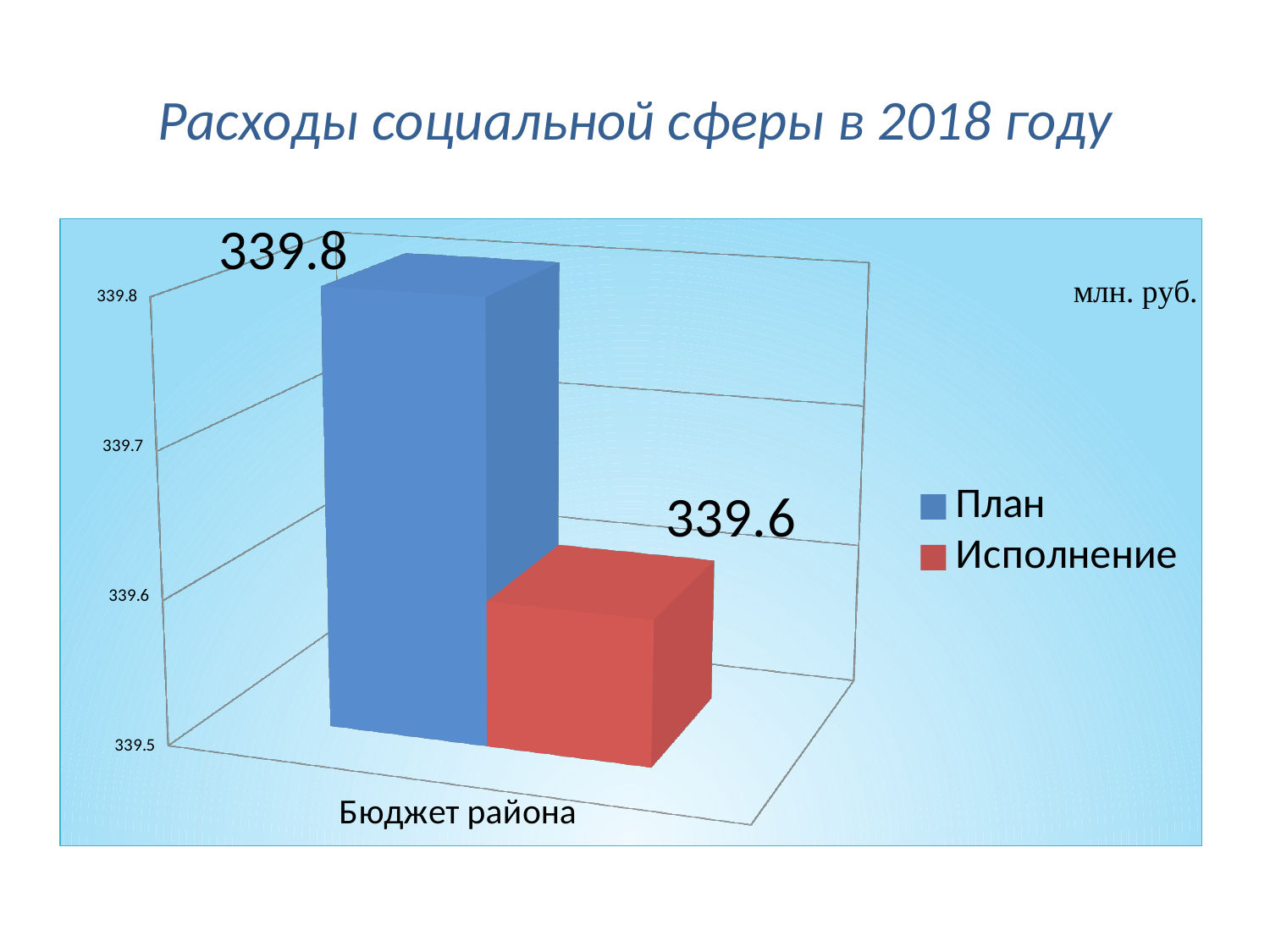
Which series has the higher value, План or Исполнение? План What is the difference between the План value and the Исполнение value? 0.2 What kind of chart is shown on the slide? Bar chart What is the value for План (Plan) for Бюджет района? 339.8 How many categories are shown on the x axis? 1 Which series has the lowest value on the chart? Исполнение How many series does the legend list? 2 What is the title of the chart on the slide? Расходы социальной сферы в 2018 году What unit is indicated on the chart? млн. руб. What is the value for Исполнение (Execution) for Бюджет района? 339.6 Is the value for Исполнение greater or less than 339.7? less